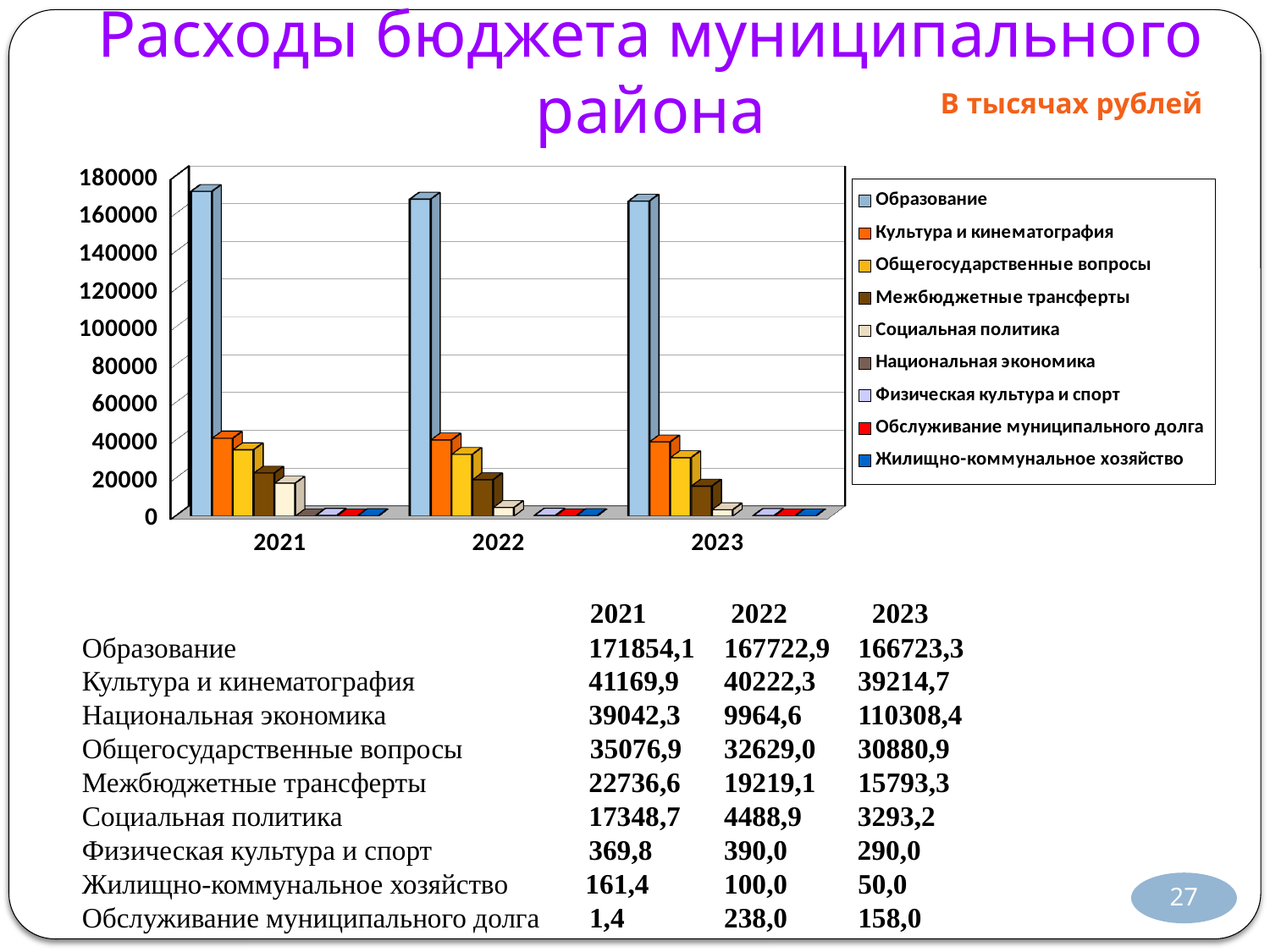
What is the difference between the Межбюджетные трансферты values for 2021 and 2023? 6943,3 Is the value for Образование in 2022 greater or less than 160000? greater Do the values for Социальная политика rise or fall from 2021 to 2023? fall How many years are shown along the x axis of the chart? 3 What kind of chart is shown on the slide? bar chart In which year is the value for Образование the highest? 2021 How many series does the chart legend list? 9 What is the value for Образование in 2021? 171854,1 In 2021, which is larger: Общегосударственные вопросы or Межбюджетные трансферты? Общегосударственные вопросы In what units are the chart values given, according to the slide? В тысячах рублей Is the value for Культура и кинематография in 2023 greater or less than 40000? less What is the value for Культура и кинематография in 2022? 40222,3